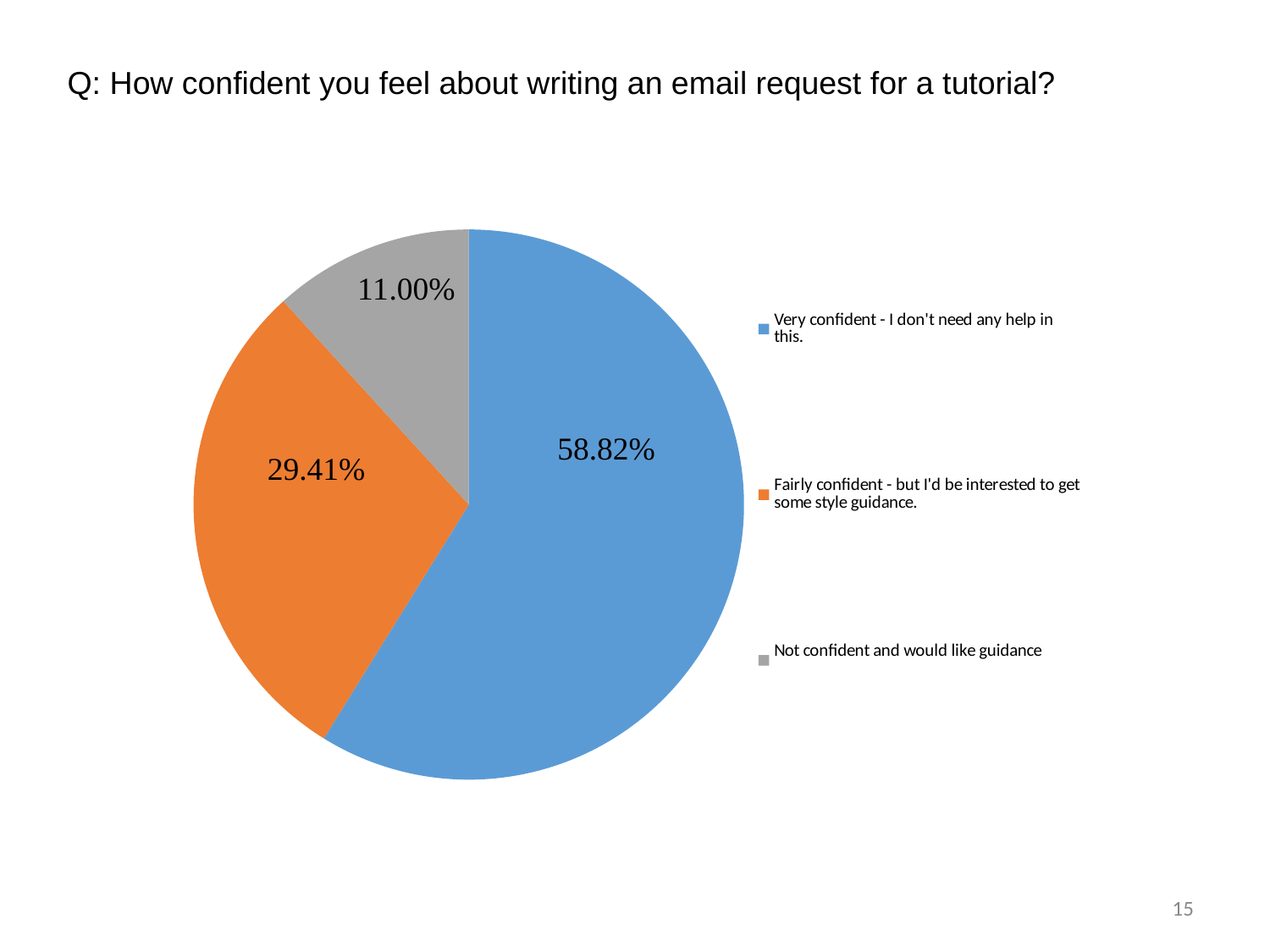
What percentage of respondents answered "Very confident - I don't need any help in this."? 58.82% What is the difference in percentage points between the "Very confident" share and the "Fairly confident" share? 29.41 What percentage of respondents answered "Not confident and would like guidance"? 11.00% What question does the slide title say the chart is about? How confident you feel about writing an email request for a tutorial? Which response has the largest share of the pie? Very confident - I don't need any help in this. What colour is the slice for "Not confident and would like guidance"? grey What kind of chart is shown on the slide? pie chart How many entries does the legend list? 3 How many slices does the pie chart have? 3 What percentage of respondents answered "Fairly confident - but I'd be interested to get some style guidance."? 29.41% Which response has the smallest share of the pie? Not confident and would like guidance Which is larger: the share for "Fairly confident" or the share for "Not confident and would like guidance"? Fairly confident - but I'd be interested to get some style guidance.